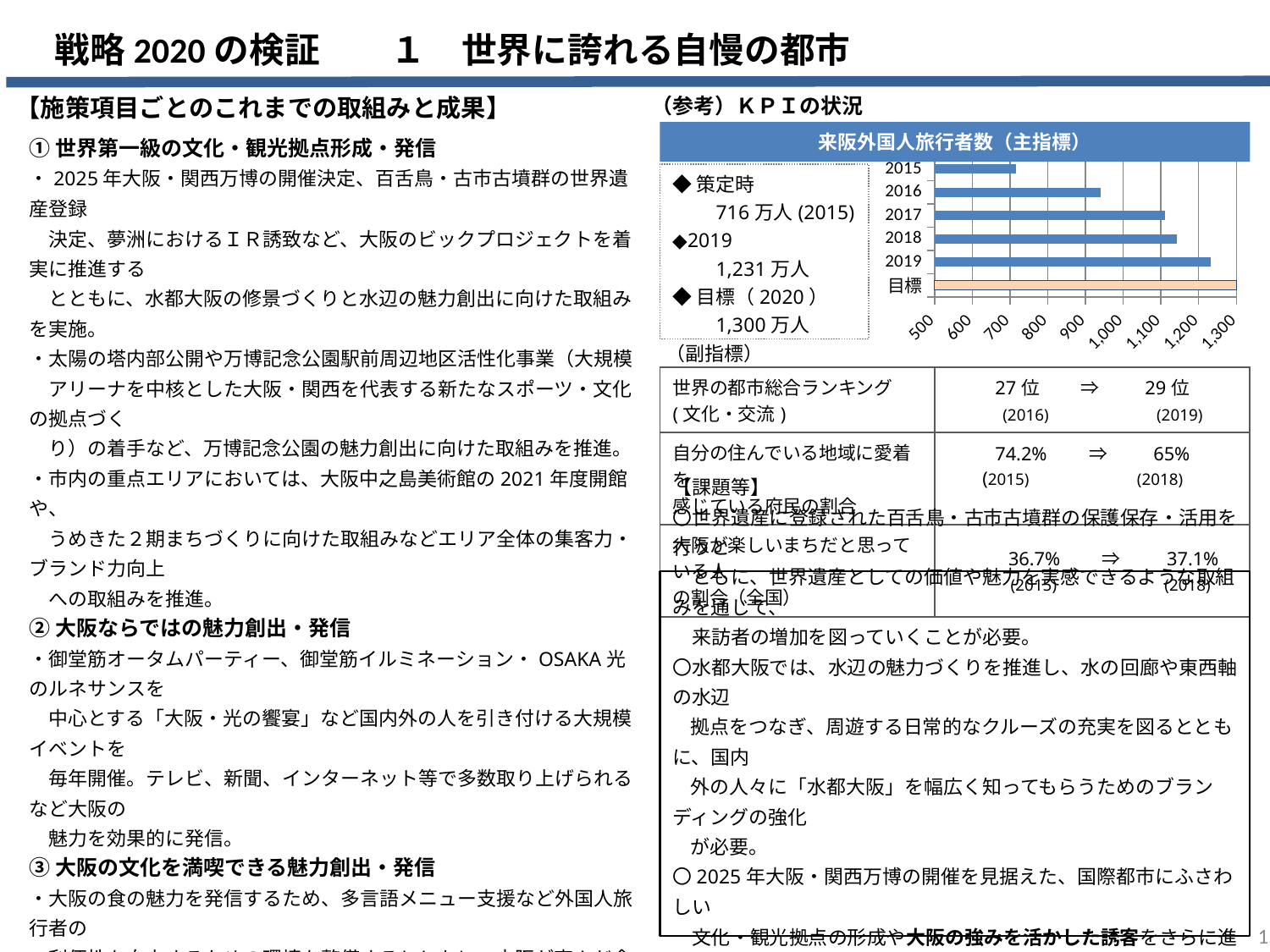
In the 来阪外国人旅行者数 chart, what is the value for 2019? 1,231万人 In the 来阪外国人旅行者数 chart, is the value for 2017 greater or less than 1,000? greater What kind of chart is shown under the title 来阪外国人旅行者数（主指標）? bar chart In the 来阪外国人旅行者数 chart, do the values rise or fall from 2015 to 2019? rise In the 来阪外国人旅行者数 chart, which year from 2015 to 2019 has the highest value? 2019 In the 来阪外国人旅行者数 chart, is the value for 2016 greater or less than 900? greater In the 来阪外国人旅行者数 chart, what is the value for 2015? 716万人 In the 来阪外国人旅行者数 chart, what is the value of the 目標 bar? 1,300万人 In the 来阪外国人旅行者数 chart, which is larger, the value for 2016 or the value for 2017? 2017 How many bars does the 来阪外国人旅行者数 chart have? 6 In the 来阪外国人旅行者数 chart, which year from 2015 to 2019 has the lowest value? 2015 In the 来阪外国人旅行者数 chart, what is the difference between the 2019 value and the 2015 value? 515万人